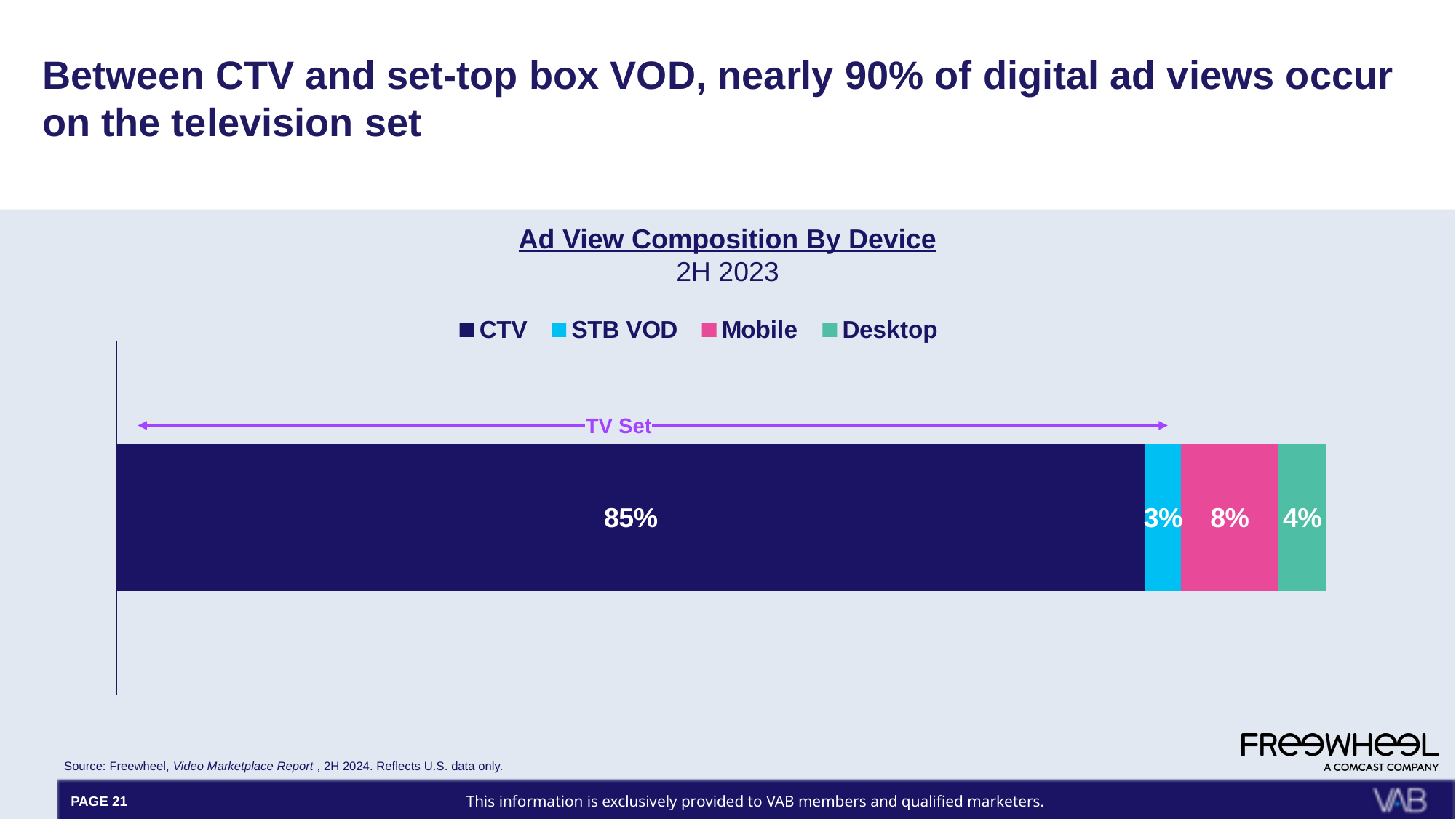
Which device has the smallest share of ad views? STB VOD How many series does the legend list? 4 What is the difference between the Mobile and Desktop shares? 4% What share of ad views does CTV account for? 85% What share of ad views does STB VOD account for? 3% What share of ad views does Desktop account for? 4% Which is larger, the Mobile share or the Desktop share? Mobile Which segments does the 'TV Set' arrow span? CTV and STB VOD What is the combined share of CTV and STB VOD? 88% What kind of chart is shown? Stacked bar chart Which device has the largest share of ad views? CTV What share of ad views does Mobile account for? 8%